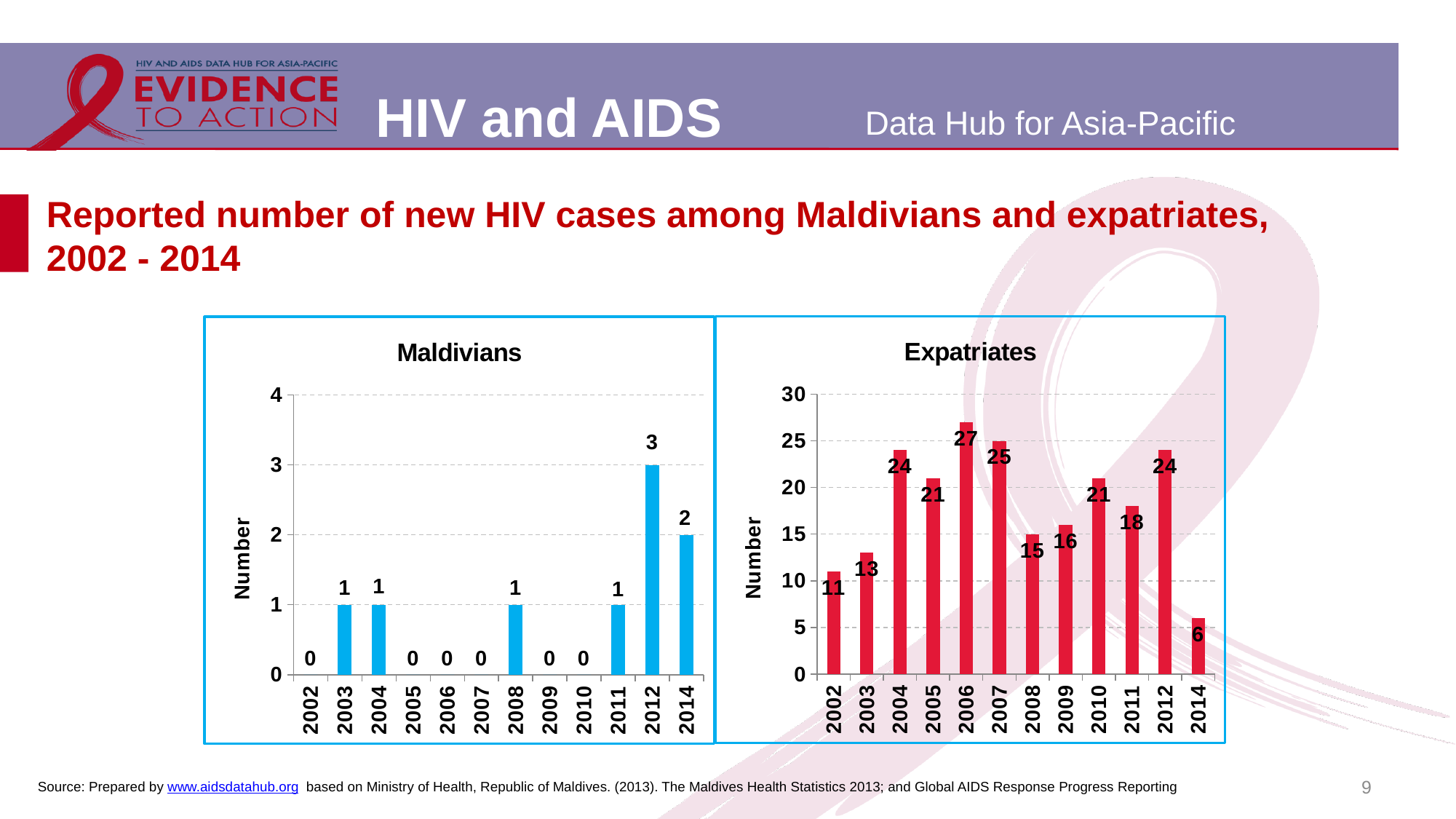
In the Expatriates chart, which year has the highest value? 2006 What type of chart is the Expatriates chart? bar chart How many years are shown on the x axis of the Maldivians chart? 12 In the Expatriates chart, which is larger, the value for 2007 or the value for 2011? 2007 What is the y-axis label on the Maldivians chart? Number In the Expatriates chart, which year has the lowest value? 2014 In the Maldivians chart, what is the value for 2012? 3 In the Expatriates chart, is the value for 2004 greater or less than 20? greater In the Expatriates chart, what is the difference between the values for 2006 and 2002? 16 In the Maldivians chart, which year has the highest value? 2012 In the Expatriates chart, what is the value for 2006? 27 In the Expatriates chart, what is the value for 2014? 6